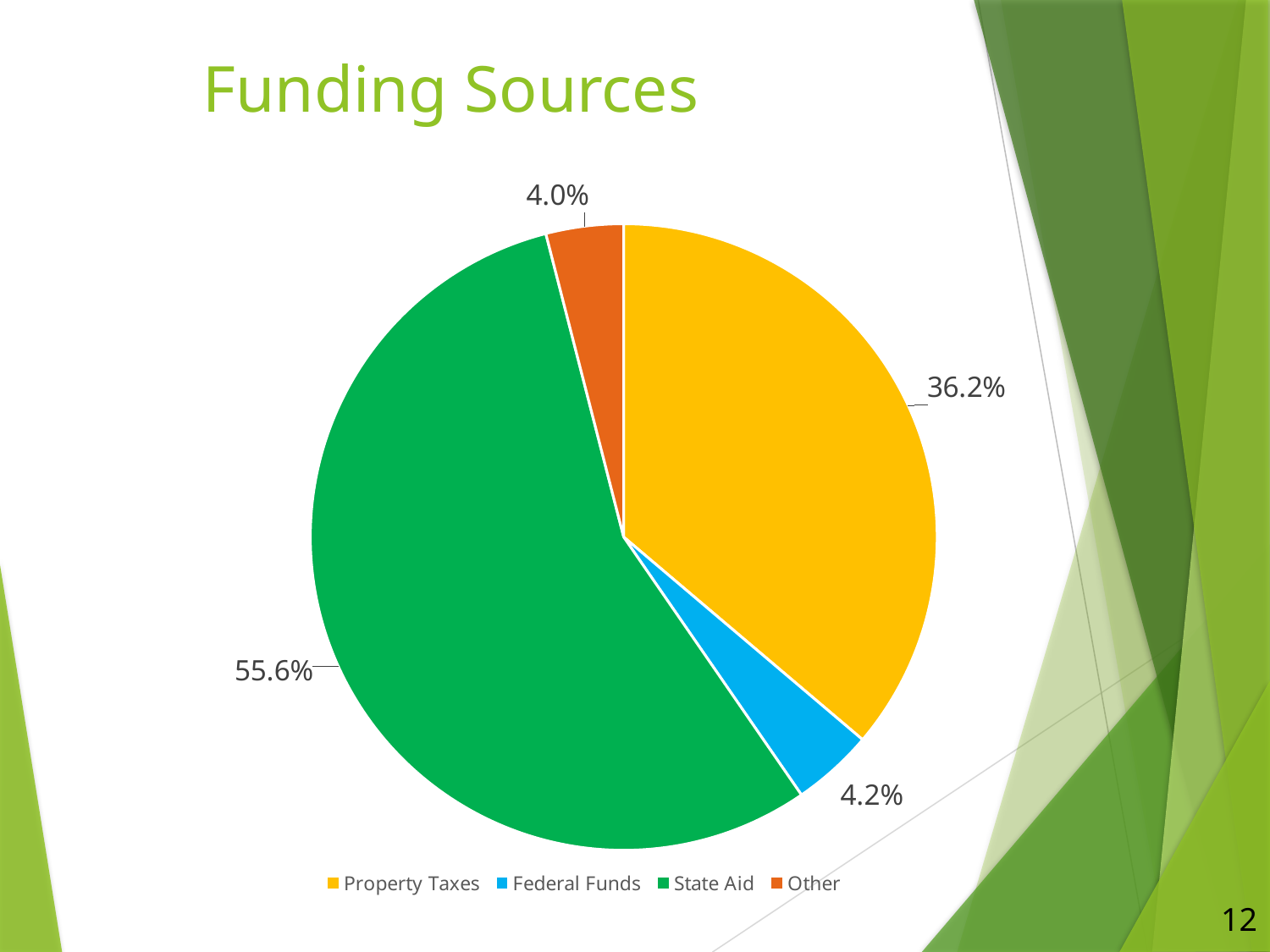
What share of funding comes from Other sources? 4.0% What is the title of the chart? Funding Sources What share of funding comes from State Aid? 55.6% What share of funding comes from Federal Funds? 4.2% What is the difference in percentage points between State Aid and Property Taxes? 19.4 Which is larger, the share for Property Taxes or the share for Federal Funds? Property Taxes What kind of chart is shown on the slide? Pie chart What colour represents Federal Funds in the pie chart? Blue Which funding source has the largest share? State Aid What share of funding comes from Property Taxes? 36.2% How many funding sources are shown in the pie chart? 4 Which funding source has the smallest share? Other